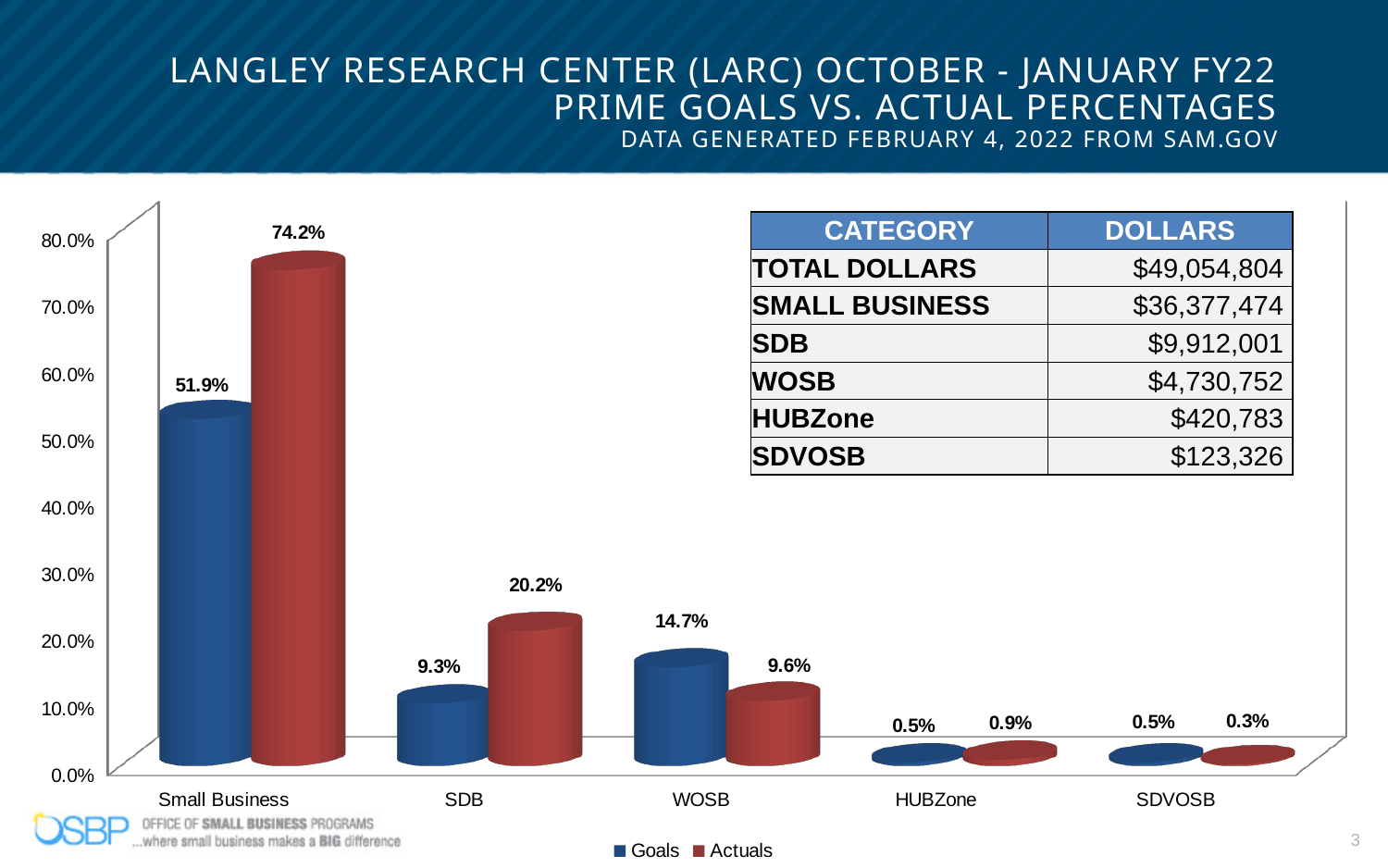
Which category has the lowest Actuals value? SDVOSB What is the Actuals value for Small Business? 74.2% What is the difference between the Goals and Actuals values for WOSB? 5.1% For SDB, which is larger, the Goals value or the Actuals value? Actuals What is the difference between the Actuals and Goals values for Small Business? 22.3% Which colour represents the Actuals series in the chart? Red Which category has the highest Actuals value? Small Business What is the Goals value for WOSB? 14.7% What kind of chart is shown on the slide? Bar chart How many series does the chart legend list? 2 How many categories are shown on the x axis of the chart? 5 What is the Actuals value for HUBZone? 0.9%